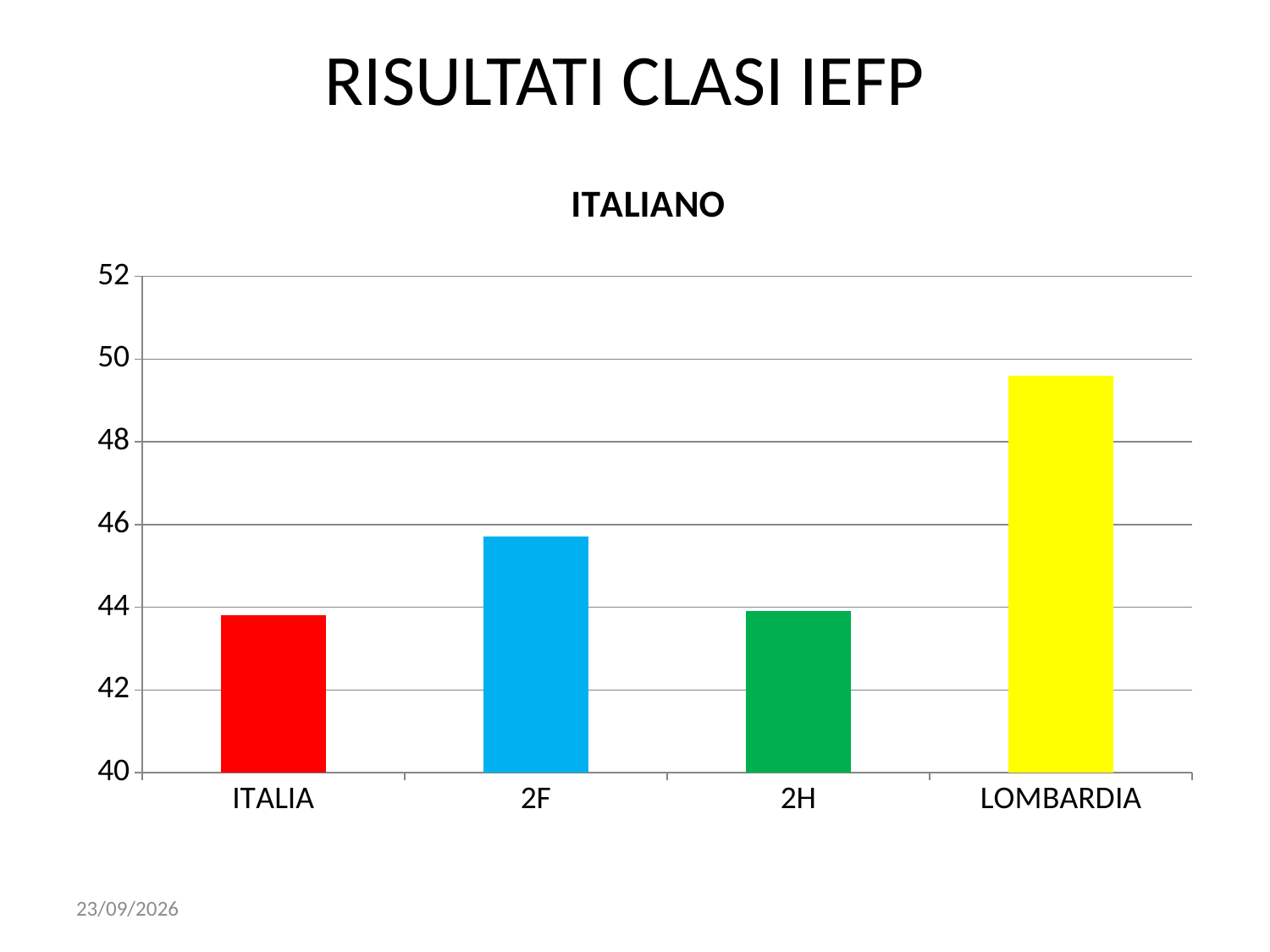
What kind of chart is shown on the slide? bar chart Is the value for 2H greater or less than 46? less What colour is the bar for LOMBARDIA? yellow Is the value for 2F greater or less than 44? greater Which category has the highest bar in the chart? LOMBARDIA How many categories are shown on the x axis of the chart? 4 Is the value for 2F greater or less than 46? less Which is larger, the value for 2F or the value for ITALIA? 2F What is the title of the chart? ITALIANO